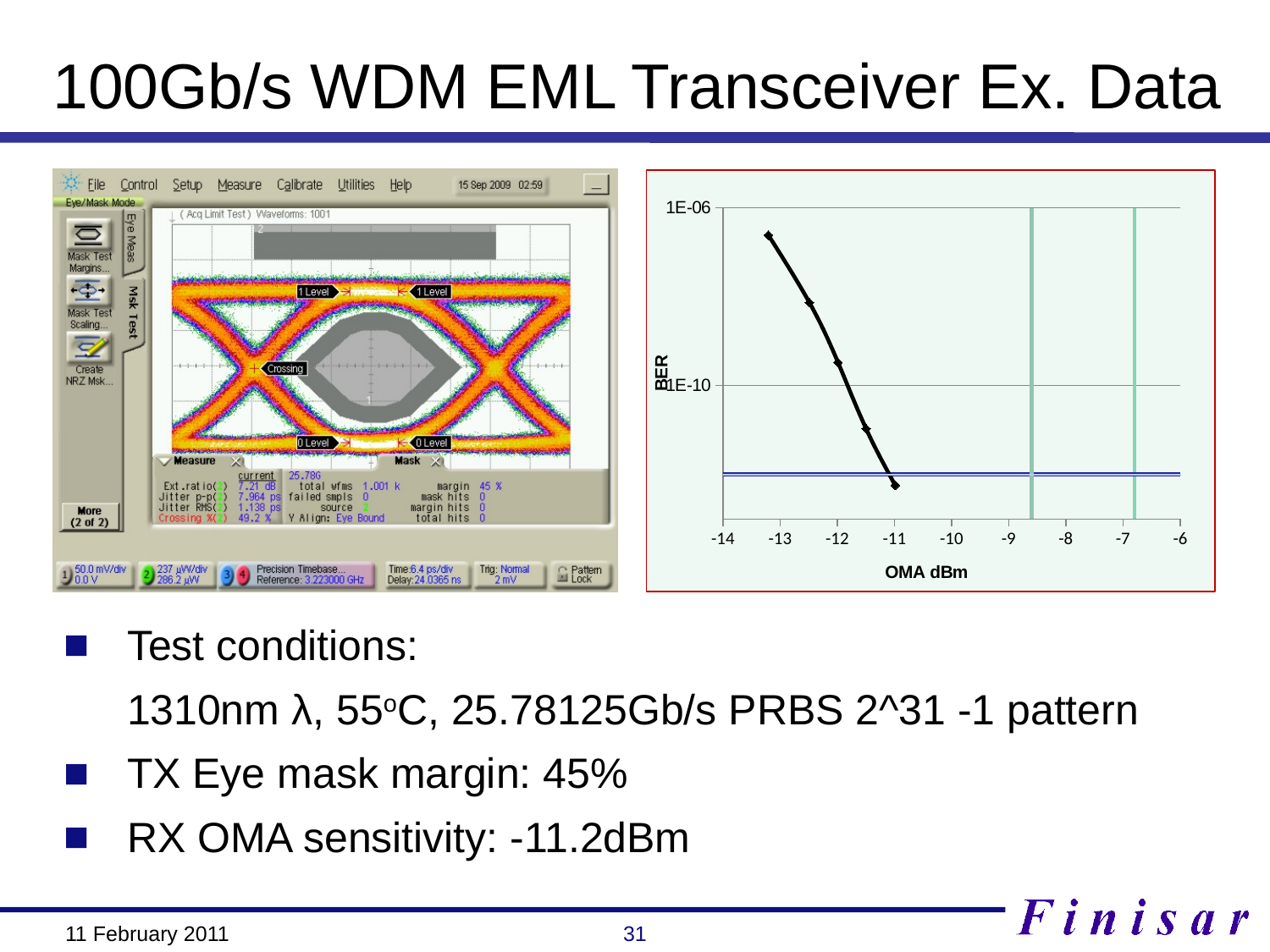
In the chart on the right, which has the higher BER: the data point at about -13 dBm OMA or the data point at -11 dBm OMA? the point at about -13 dBm In the chart on the right, does BER rise or fall as OMA increases along the x axis? fall In the chart on the right, is the BER at an OMA of about -13 dBm greater or less than 1E-10? greater In the chart on the right, is the BER at the leftmost data point greater or less than 1E-06? less In the chart on the right, is the BER at an OMA of -11 dBm greater or less than 1E-10? less What kind of chart is the BER vs OMA chart on the right of the slide? line chart In the chart on the right, what is the label of the x axis? OMA dBm What is the lowest OMA value shown on the x axis of the chart on the right? -14 In the chart on the right, what is the label of the y axis? BER How many data points are plotted on the BER curve in the chart on the right? 5